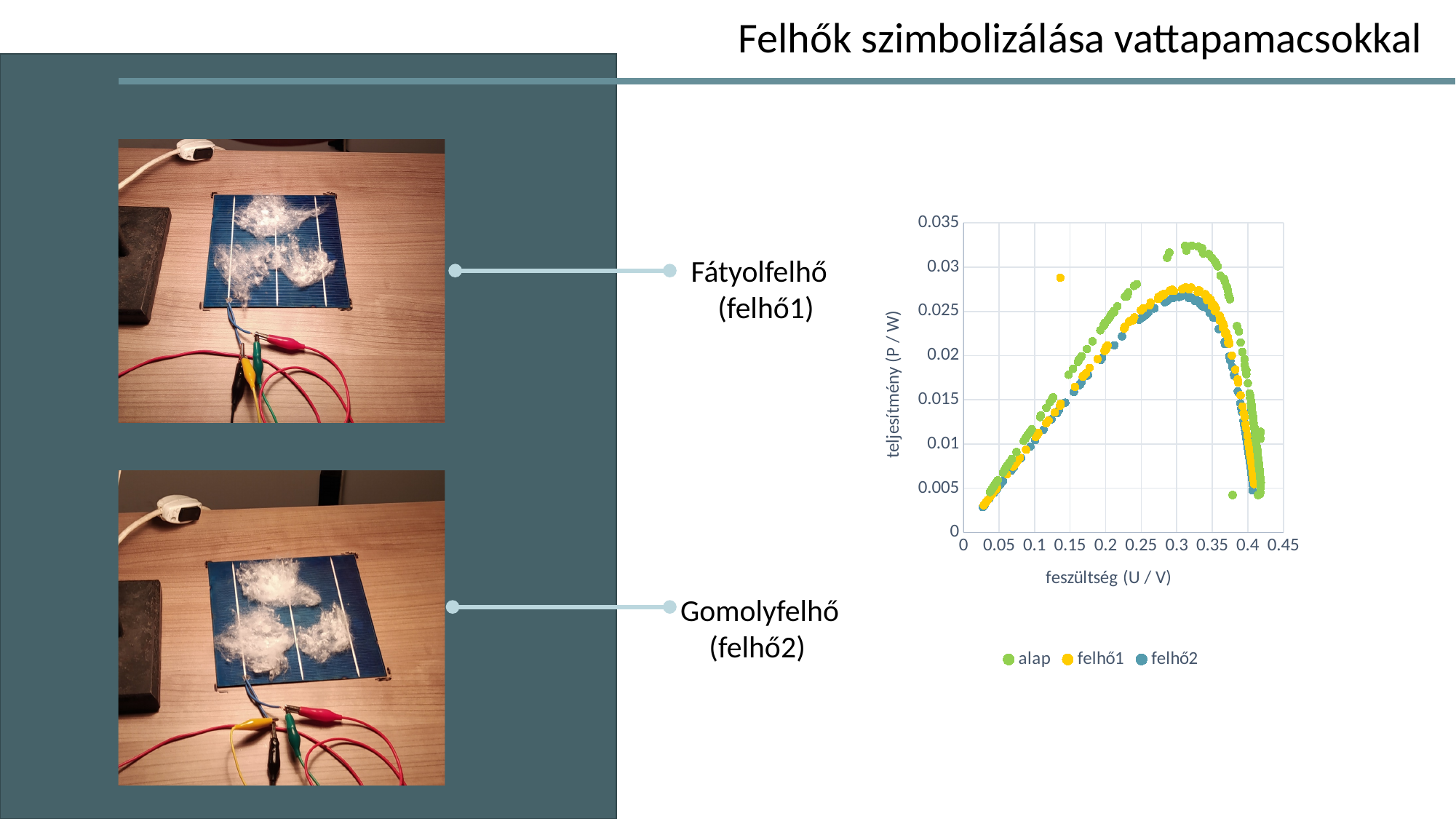
Is the peak value of the felhő1 series greater or less than 0.03? less Which series reaches the highest power (teljesítmény) value on the chart? alap What kind of chart is shown on the slide? scatter chart How do the power values change as voltage increases from 0 to about 0.3 V? they rise Is the peak value of the alap series greater or less than 0.03? greater What is the title of the chart's horizontal axis? feszültség (U / V) Is the maximum value shown on the vertical axis greater or less than 0.03? greater How many series does the chart legend list? 3 How do the power values change as voltage increases beyond about 0.35 V? they fall What are the names of the series listed in the chart legend? alap, felhő1, felhő2 Which series has the higher peak power: alap or felhő2? alap